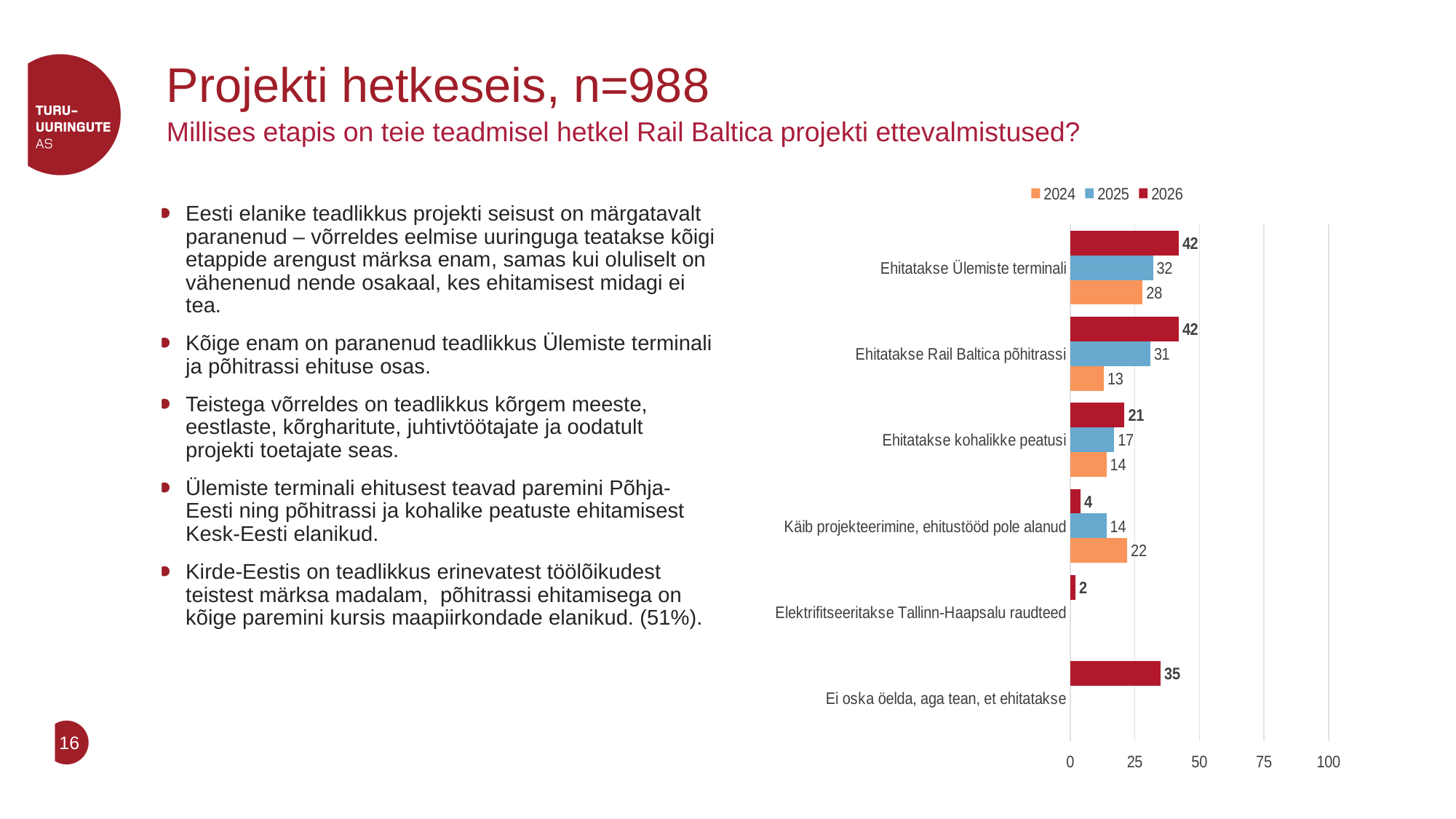
How many categories are shown on the chart? 6 Which category has the highest 2024 value? Ehitatakse Ülemiste terminali For "Käib projekteerimine, ehitustööd pole alanud", which is larger: the 2024 value or the 2026 value? 2024 How many series does the chart legend list? 3 What is the difference between the 2026 and 2024 values for "Ehitatakse Rail Baltica põhitrassi"? 29 What is the 2025 value for "Ehitatakse kohalikke peatusi"? 17 What is the 2026 value for "Ehitatakse Ülemiste terminali"? 42 What is the 2026 value for "Ei oska öelda, aga tean, et ehitatakse"? 35 Which series is shown in orange in the legend? 2024 What is the 2024 value for "Ehitatakse Rail Baltica põhitrassi"? 13 Which category has the lowest 2026 value? Elektrifitseeritakse Tallinn-Haapsalu raudteed What kind of chart is shown on the slide? bar chart